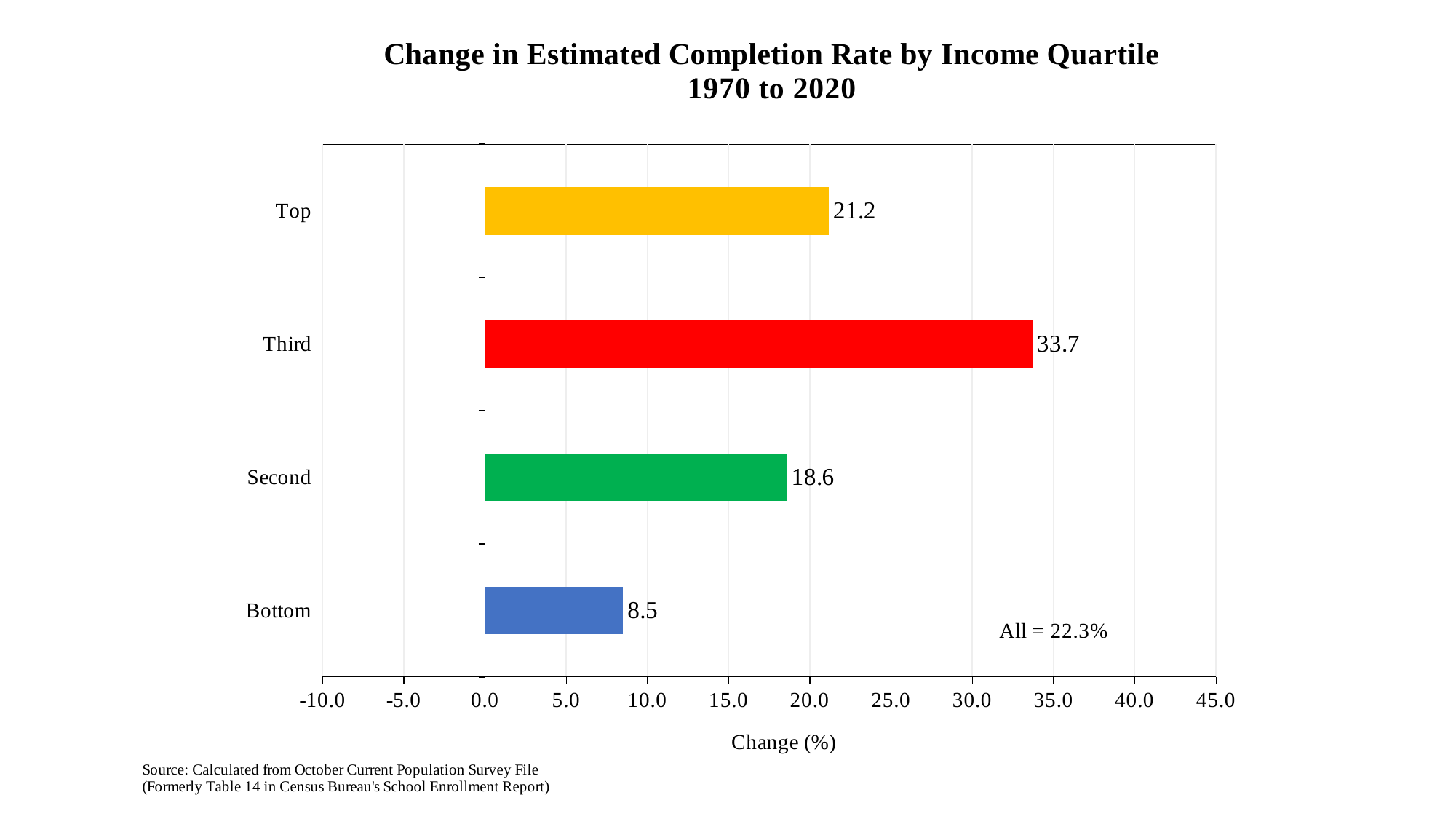
What value is given for 'All' in the chart annotation? 22.3% Which has a larger change in completion rate, the Top quartile or the Second quartile? Top What is the change in estimated completion rate for the Bottom income quartile? 8.5 What is the difference between the values for the Top and Bottom quartiles? 12.7 Is the value for the Third quartile greater or less than 30.0? greater What is the value shown for the Top income quartile? 21.2 Which income quartile has the lowest change in estimated completion rate? Bottom Which income quartile has the highest change in estimated completion rate? Third What is the change in estimated completion rate for the Third income quartile? 33.7 What kind of chart is shown on the slide? Bar chart What is the difference between the values for the Third and Second quartiles? 15.1 How many income quartile categories are shown in the chart? 4